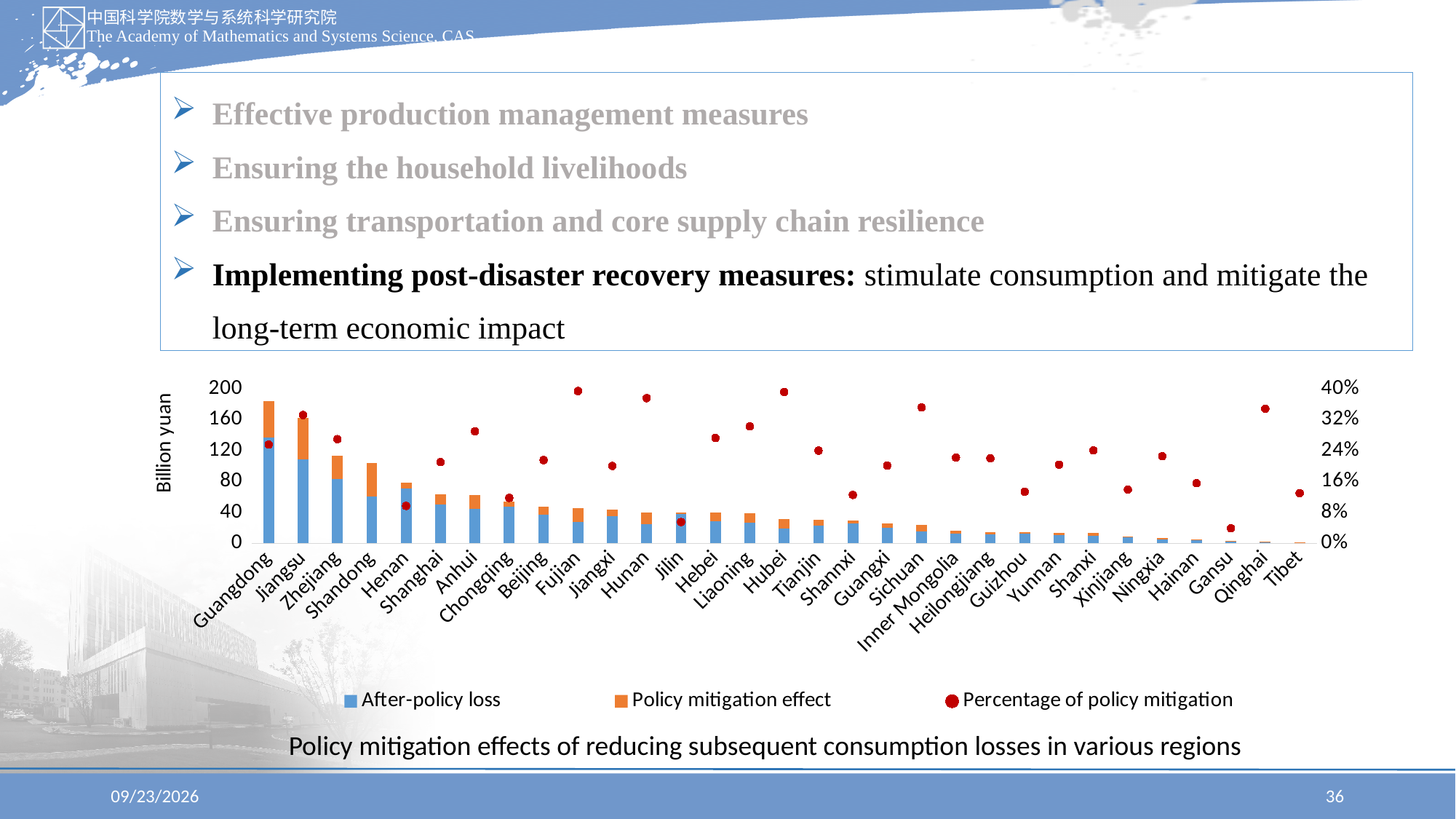
Which region has the smallest stacked bar? Tibet Which region has the lowest Percentage of policy mitigation? Gansu Do the stacked bar totals generally rise or fall moving from left to right along the x axis? fall Is the total stacked bar for Guangdong greater or less than 160 billion yuan? greater Is the Percentage of policy mitigation for Tibet greater or less than 16%? less How many regions are shown on the x axis of the chart? 31 Which region has the tallest stacked bar (largest total loss before policy)? Guangdong Which has the larger total stacked bar, Guangdong or Jiangsu? Guangdong What kind of chart is used to show the After-policy loss and Policy mitigation effect series? Stacked bar chart What is the title of the chart? Policy mitigation effects of reducing subsequent consumption losses in various regions How many series does the chart legend list? 3 Is the Percentage of policy mitigation for Fujian greater or less than 32%? greater